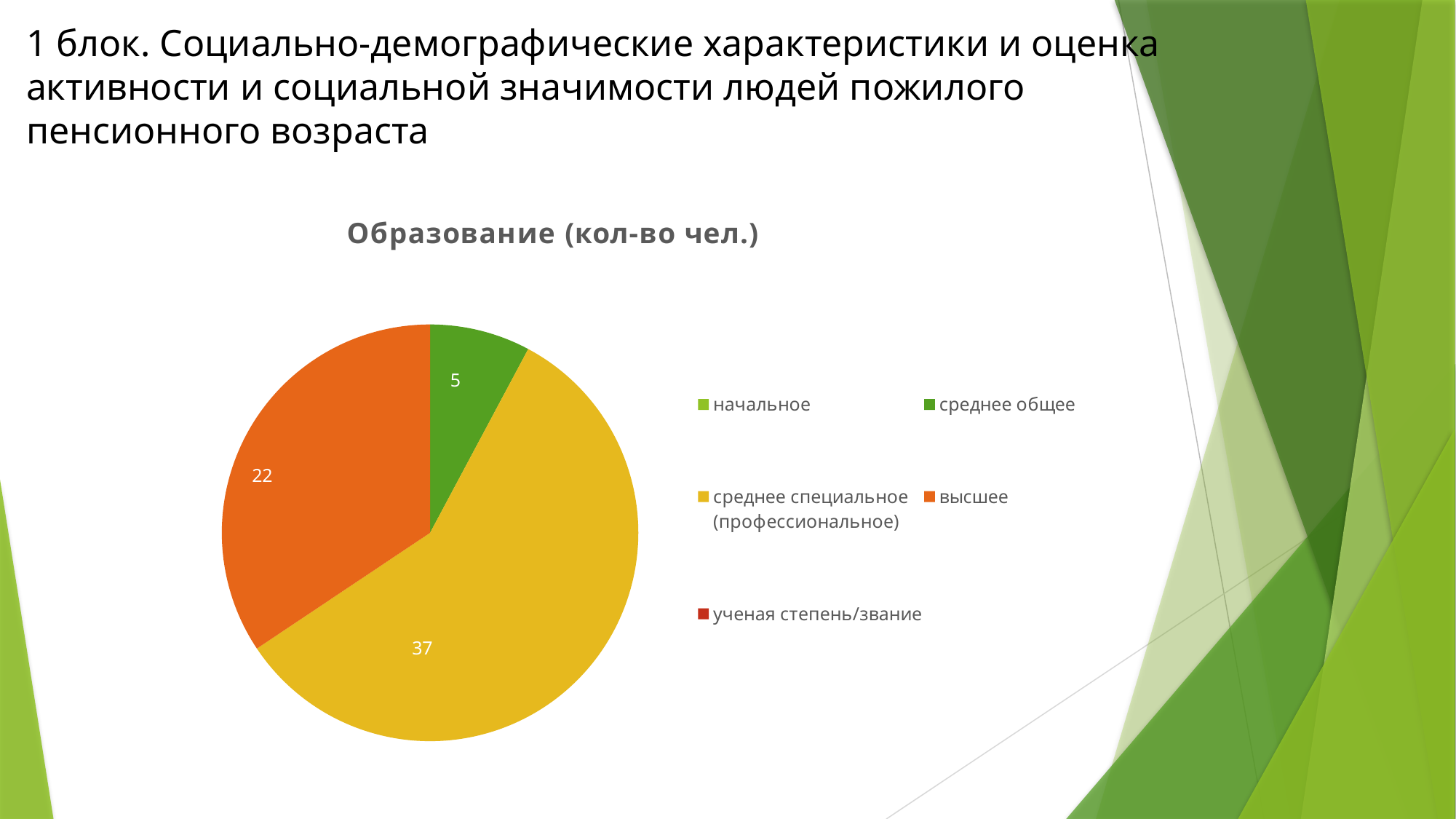
What value is shown for the "среднее специальное (профессиональное)" slice in the pie chart? 37 Which education category has the largest slice in the pie chart? среднее специальное (профессиональное) Of the slices that carry a data label, which category has the smallest value? среднее общее What value is shown for the "среднее общее" slice in the pie chart? 5 What is the difference between the values for "среднее специальное (профессиональное)" and "высшее"? 15 Which is larger, the value for "высшее" or the value for "среднее общее"? высшее What value is shown for the "высшее" slice in the pie chart? 22 What is the title of the chart on the slide? Образование (кол-во чел.) What is the difference between the values for "высшее" and "среднее общее"? 17 What type of chart is shown on the slide? pie chart How many categories does the legend of the pie chart list? 5 How many slices in the pie chart have a data label printed on them? 3